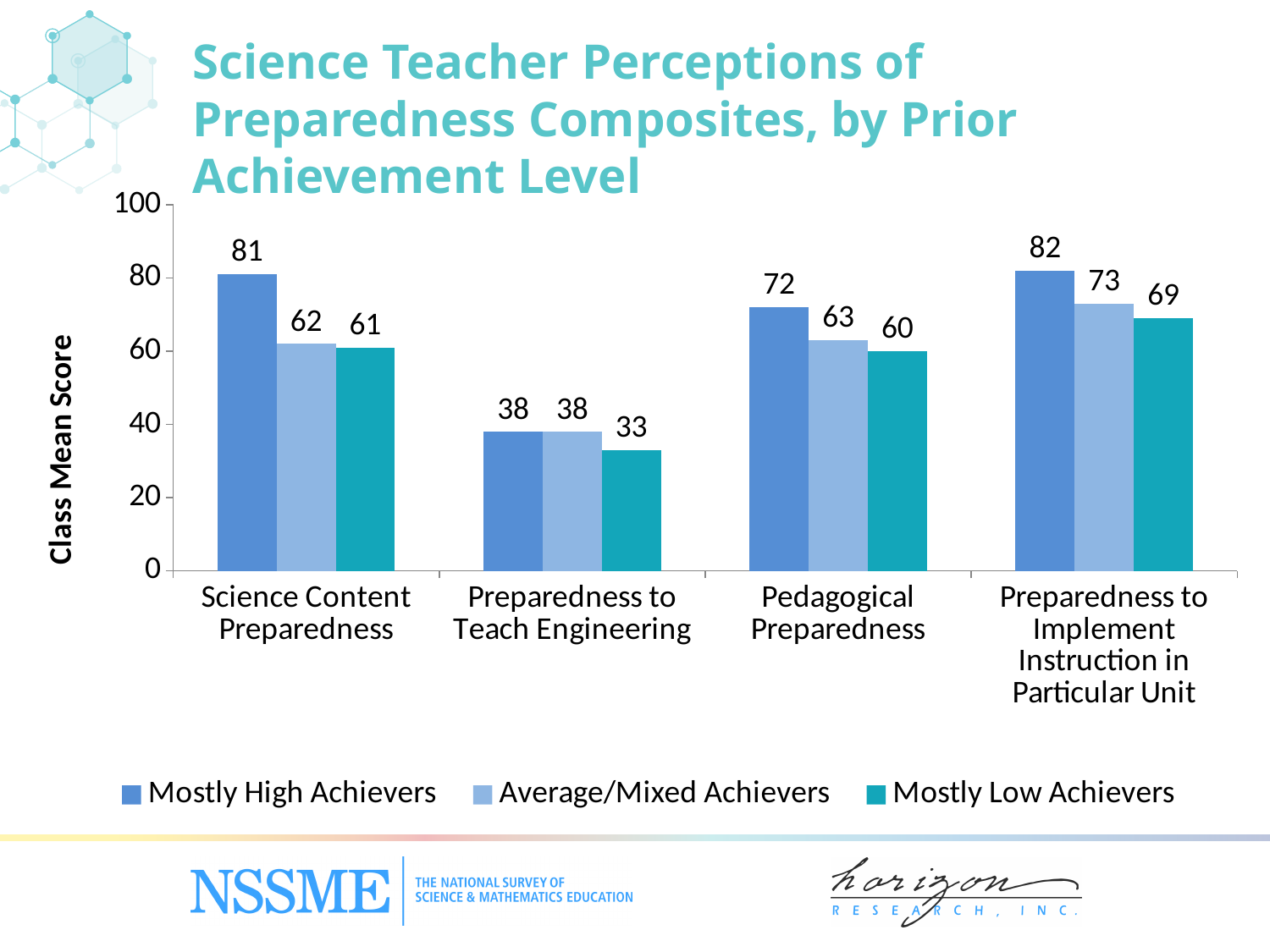
What is the Pedagogical Preparedness score for Average/Mixed Achievers? 63 What is the Preparedness to Teach Engineering score for Mostly Low Achievers? 33 Which category has the highest score for Mostly High Achievers? Preparedness to Implement Instruction in Particular Unit What is the Science Content Preparedness score for Mostly High Achievers? 81 How many series does the legend list? 3 What is the difference between the Average/Mixed Achievers and Mostly Low Achievers scores for Preparedness to Implement Instruction in Particular Unit? 4 What kind of chart is shown on the slide? Bar chart Which is larger for Pedagogical Preparedness: the Mostly High Achievers score or the Mostly Low Achievers score? Mostly High Achievers What is the difference between the Mostly High Achievers and Mostly Low Achievers scores for Science Content Preparedness? 20 What is the label of the y axis? Class Mean Score Which category has the lowest score for Mostly Low Achievers? Preparedness to Teach Engineering How many categories are shown on the x axis? 4